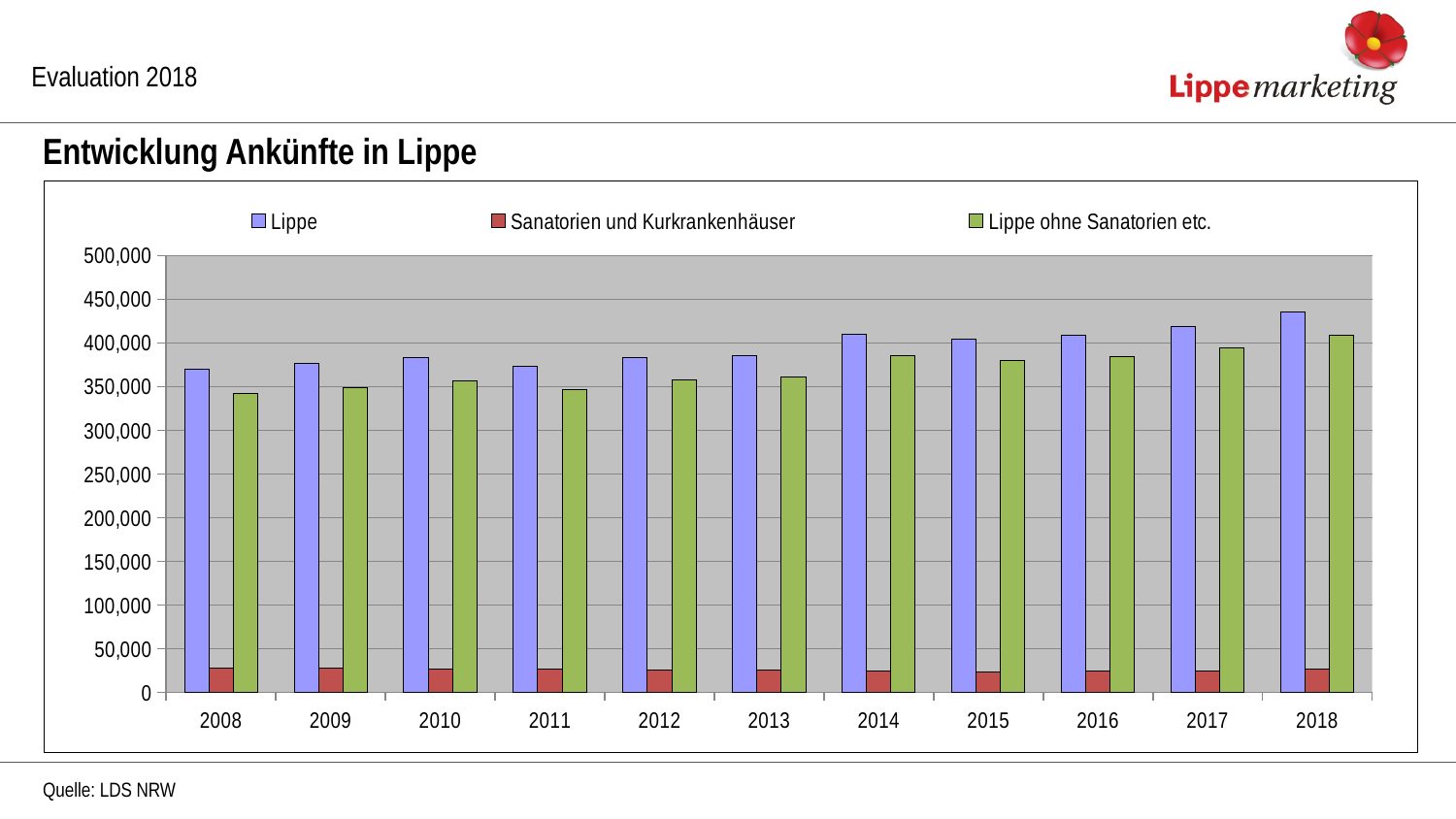
Overall, do the values for Lippe rise or fall from 2008 to 2018? rise Which is larger: the value for Lippe in 2018 or in 2008? 2018 In which year is the value for Lippe ohne Sanatorien etc. highest? 2018 How many years are shown on the x axis? 11 Is the value for Sanatorien und Kurkrankenhäuser in 2012 greater or less than 50,000? less What is the title of the chart? Entwicklung Ankünfte in Lippe Which is larger: the value for Lippe ohne Sanatorien etc. in 2014 or in 2013? 2014 How many series does the legend list? 3 In which year is the value for Lippe highest? 2018 Is the value for Lippe in 2008 greater or less than 400,000? less What kind of chart is shown on the slide? bar chart Is the value for Lippe in 2018 greater or less than 400,000? greater